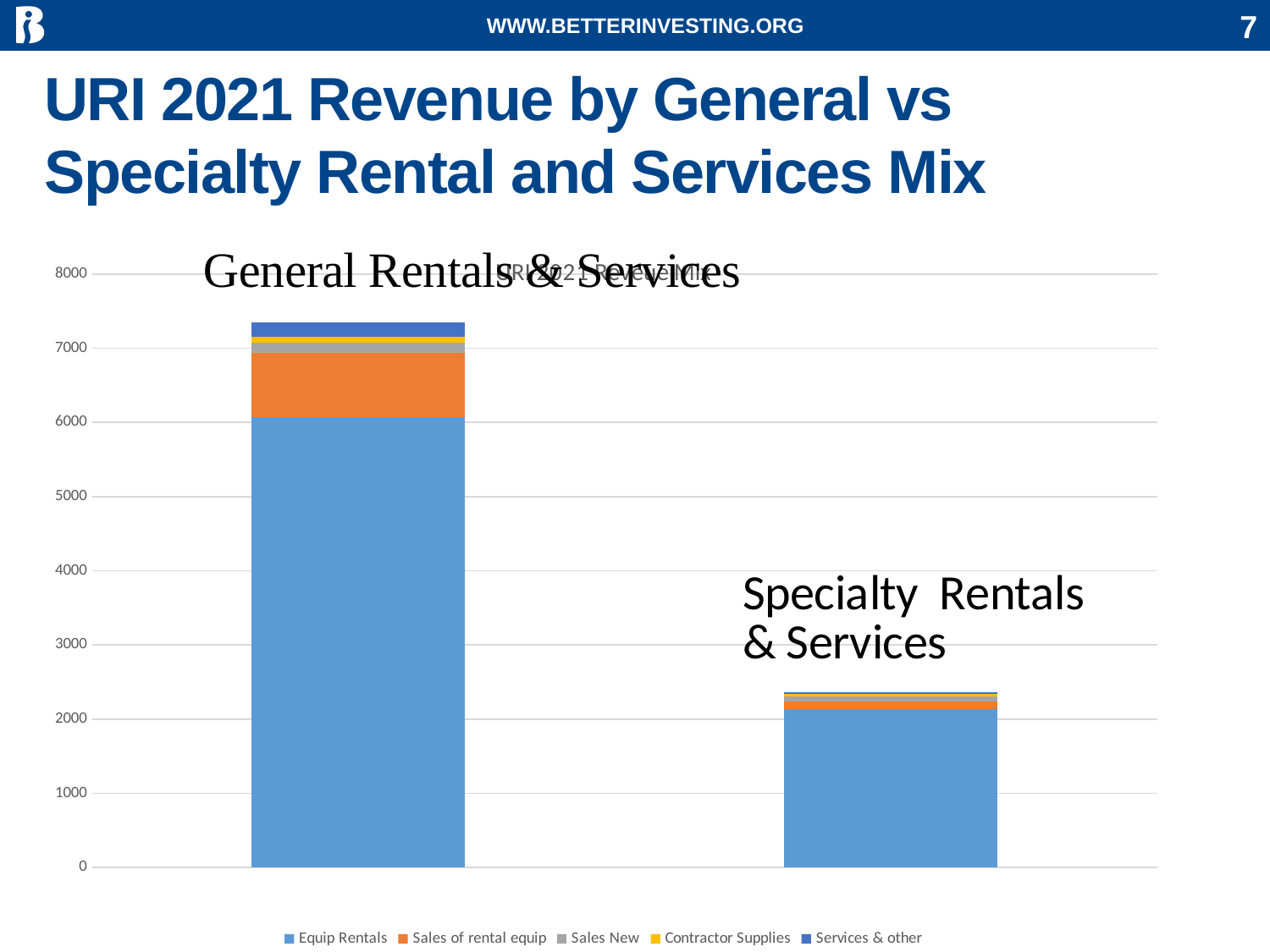
Is the Equip Rentals segment of the General Rentals & Services bar greater or less than 5000? greater Which category has the lowest total revenue in the chart? Specialty Rentals & Services How many bars (categories) are plotted in the chart? 2 What is the first series listed in the chart legend? Equip Rentals Is the total of the Specialty Rentals & Services bar greater or less than 2000? greater How many series does the legend list? 5 Is the total of the Specialty Rentals & Services bar greater or less than 3000? less What is the last series listed in the chart legend? Services & other What kind of chart is shown on the slide? stacked bar chart Which series makes up the largest segment of the General Rentals & Services bar? Equip Rentals Which category has the taller stacked bar, General Rentals & Services or Specialty Rentals & Services? General Rentals & Services